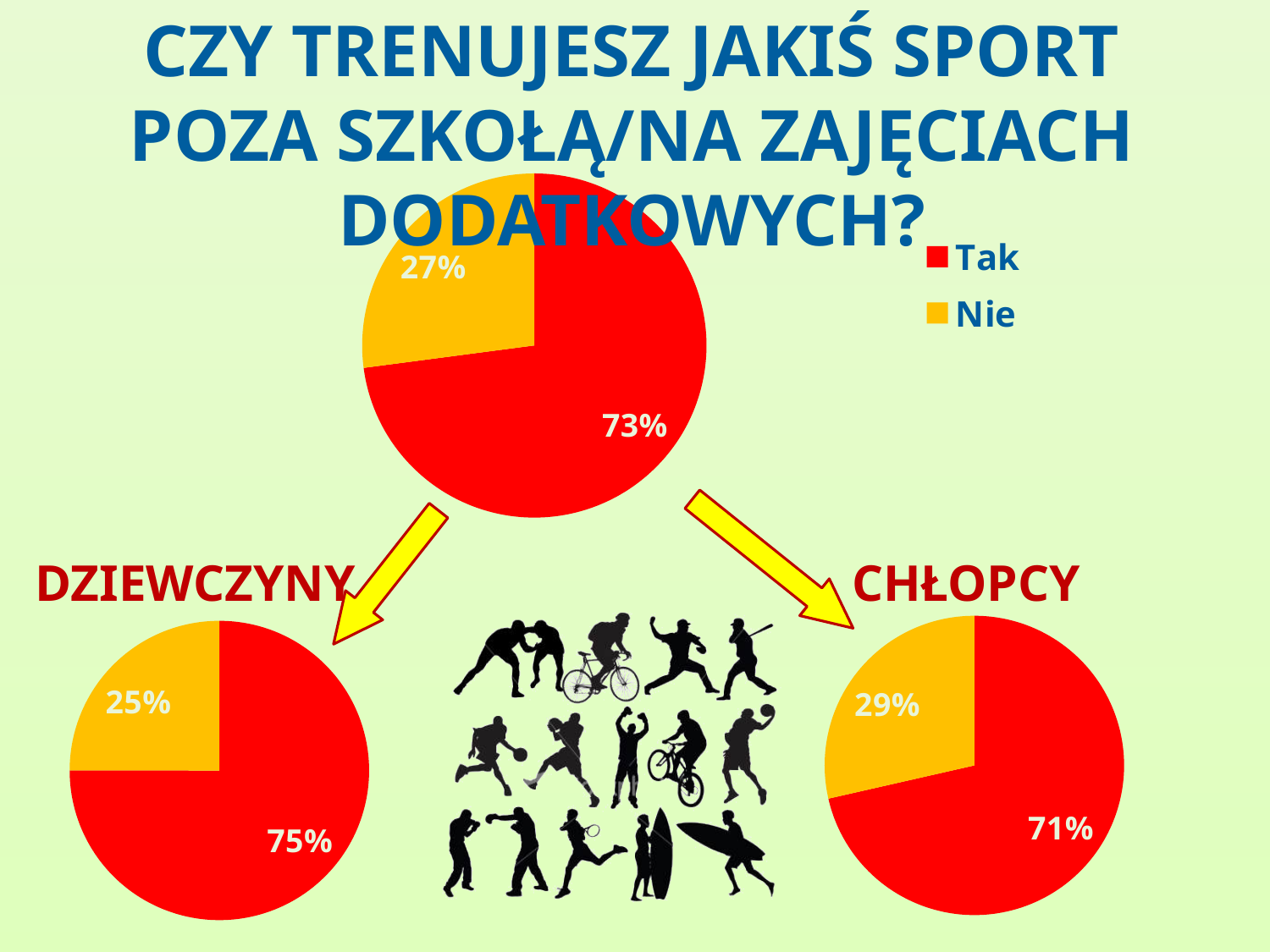
In the CHŁOPCY pie chart, which slice is the smallest? Nie In the DZIEWCZYNY pie chart, what percentage is shown for "Tak"? 75% What is the difference between the "Tak" share in the DZIEWCZYNY chart and the "Tak" share in the CHŁOPCY chart? 4% In the top pie chart, which slice is the largest? Tak In the CHŁOPCY pie chart, what percentage is shown for "Nie"? 29% In the CHŁOPCY pie chart, what percentage is shown for "Tak"? 71% What type of chart is used on this slide? Pie chart How many entries does the legend list? 2 In the top pie chart, what percentage is shown for "Tak"? 73% In the DZIEWCZYNY pie chart, what percentage is shown for "Nie"? 25% In the top pie chart, what percentage is shown for "Nie"? 27% Which is larger: the "Tak" share in the DZIEWCZYNY chart or the "Tak" share in the CHŁOPCY chart? DZIEWCZYNY